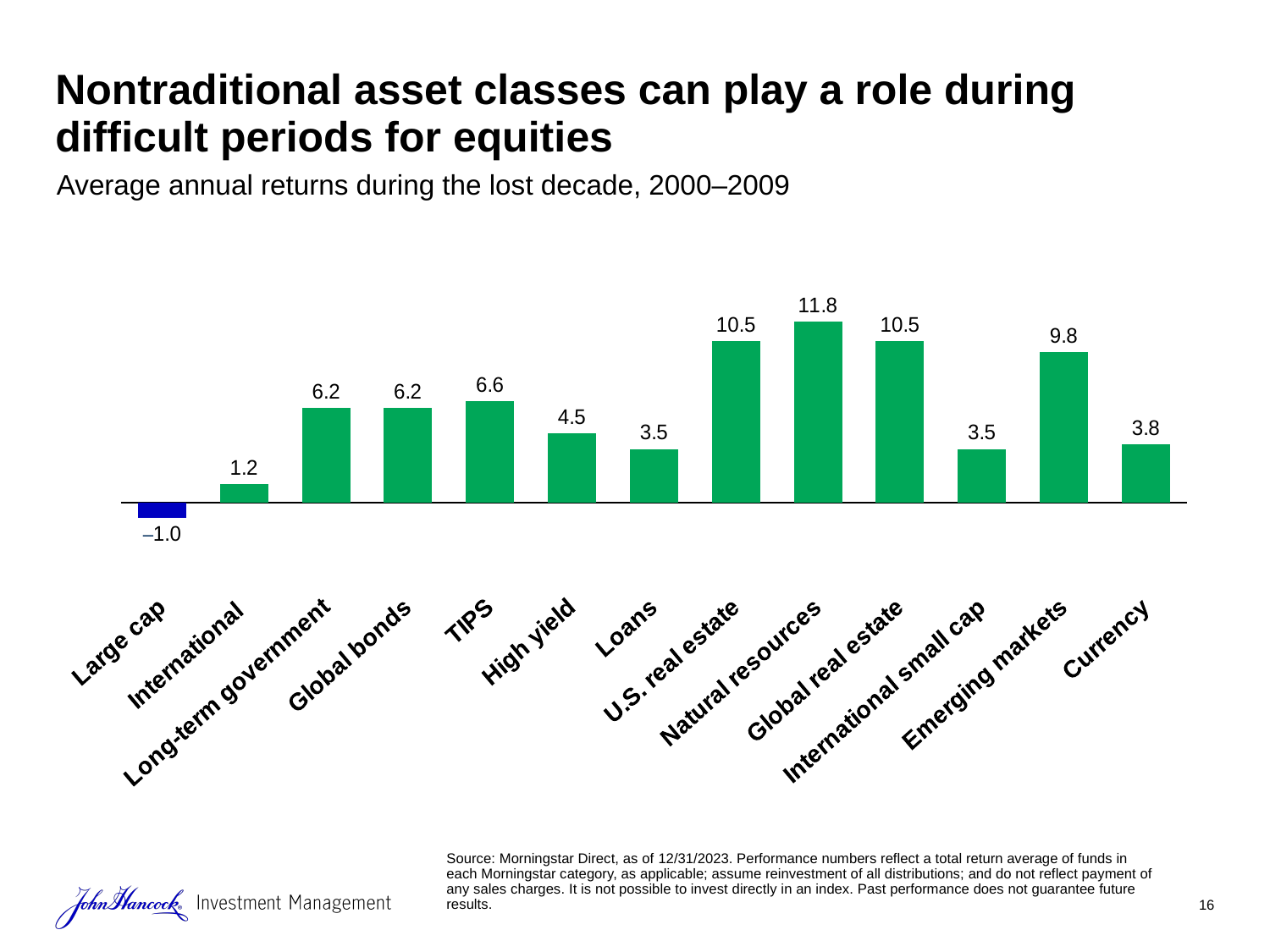
Which asset class has the lowest average annual return on the chart? Large cap What is the value shown for TIPS? 6.6 What is the average annual return shown for Natural resources? 11.8 Which bar is shown in a different colour (blue) from the others? Large cap Which asset class has the highest average annual return on the chart? Natural resources How many asset classes are shown on the chart? 13 What kind of chart is shown on the slide? Bar chart What is the value shown for Emerging markets? 9.8 What is the difference between the values for Natural resources and U.S. real estate? 1.3 What is the value shown for Large cap? –1.0 What is the difference between the values for High yield and Loans? 1.0 Which is larger, the value for Emerging markets or the value for Global real estate? Global real estate